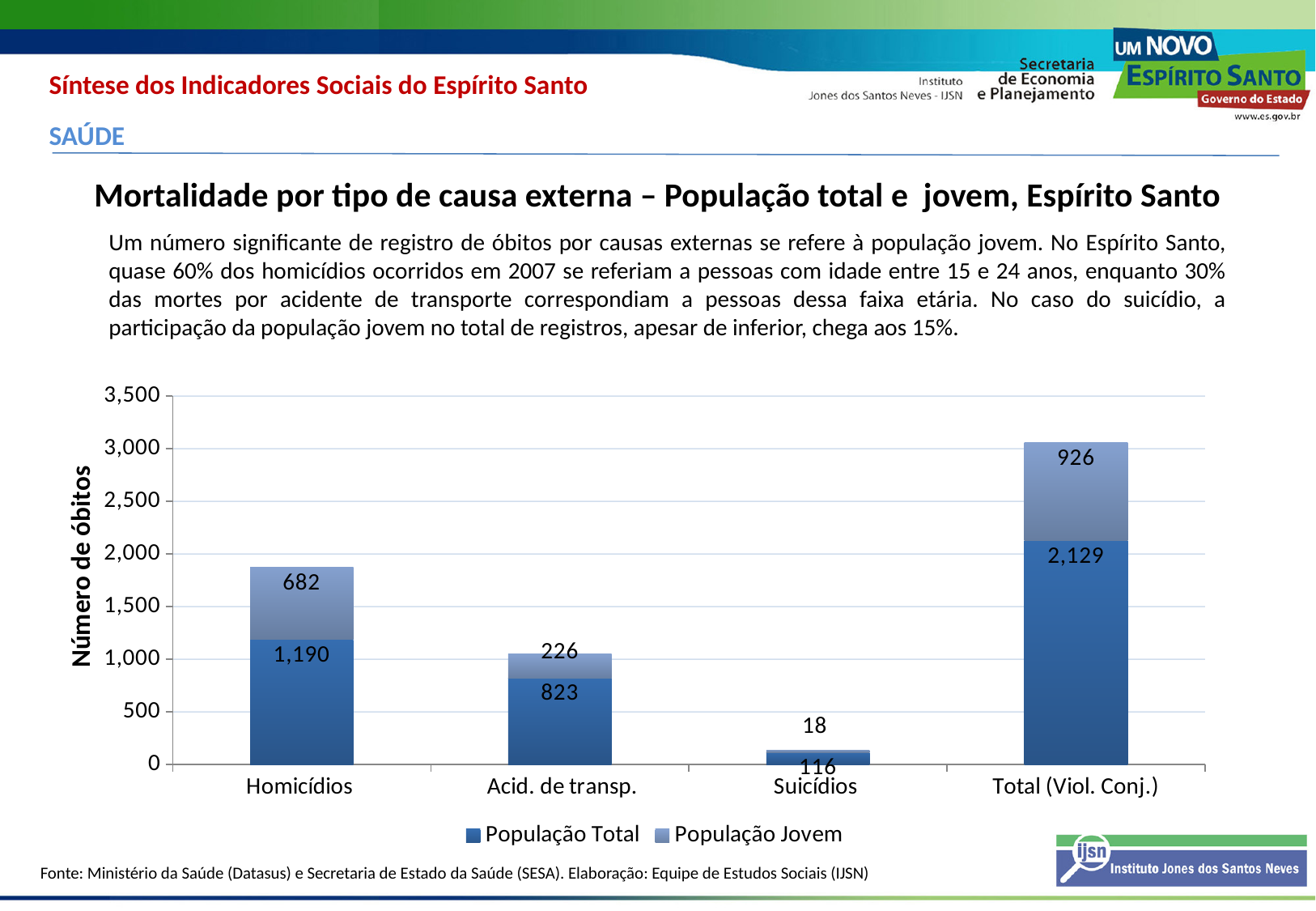
What is the total of the stacked bar for Acid. de transp.? 1,049 Which is larger: População Jovem for Homicídios or População Jovem for Acid. de transp.? Homicídios What is the value of População Total for Suicídios? 116 How many series does the legend list? 2 What is the value of População Jovem for Total (Viol. Conj.)? 926 What is the value of População Jovem for Acid. de transp.? 226 How many categories are shown on the x axis? 4 What is the difference between População Total and População Jovem for Homicídios? 508 What type of chart is shown on the slide? stacked bar chart What is the value of População Total for Homicídios? 1,190 Which category has the lowest value for População Jovem? Suicídios Which category has the highest value for População Total? Total (Viol. Conj.)